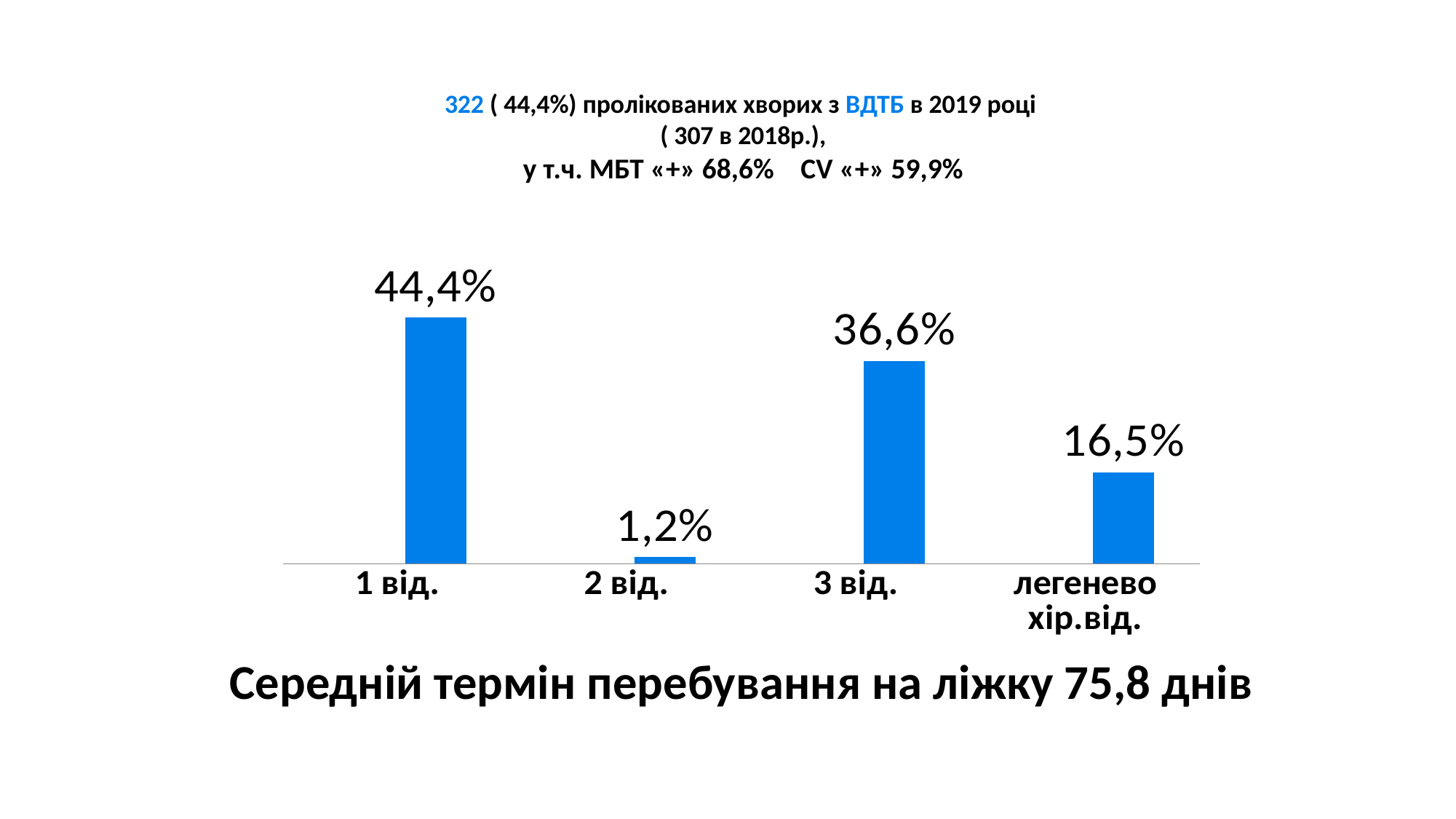
How many categories are shown in the chart? 4 What is the value for 1 від.? 44,4% What colour are the bars in the chart? blue Which is larger, the value for 3 від. or the value for легенево хір.від.? 3 від. What is the value for легенево хір.від.? 16,5% Which category has the highest value? 1 від. Which category has the lowest value? 2 від. What is the difference between the values for 1 від. and 3 від.? 7,8% What is the value for 2 від.? 1,2% What kind of chart is shown on the slide? bar chart What is the value for 3 від.? 36,6% What is the difference between the values for 3 від. and легенево хір.від.? 20,1%